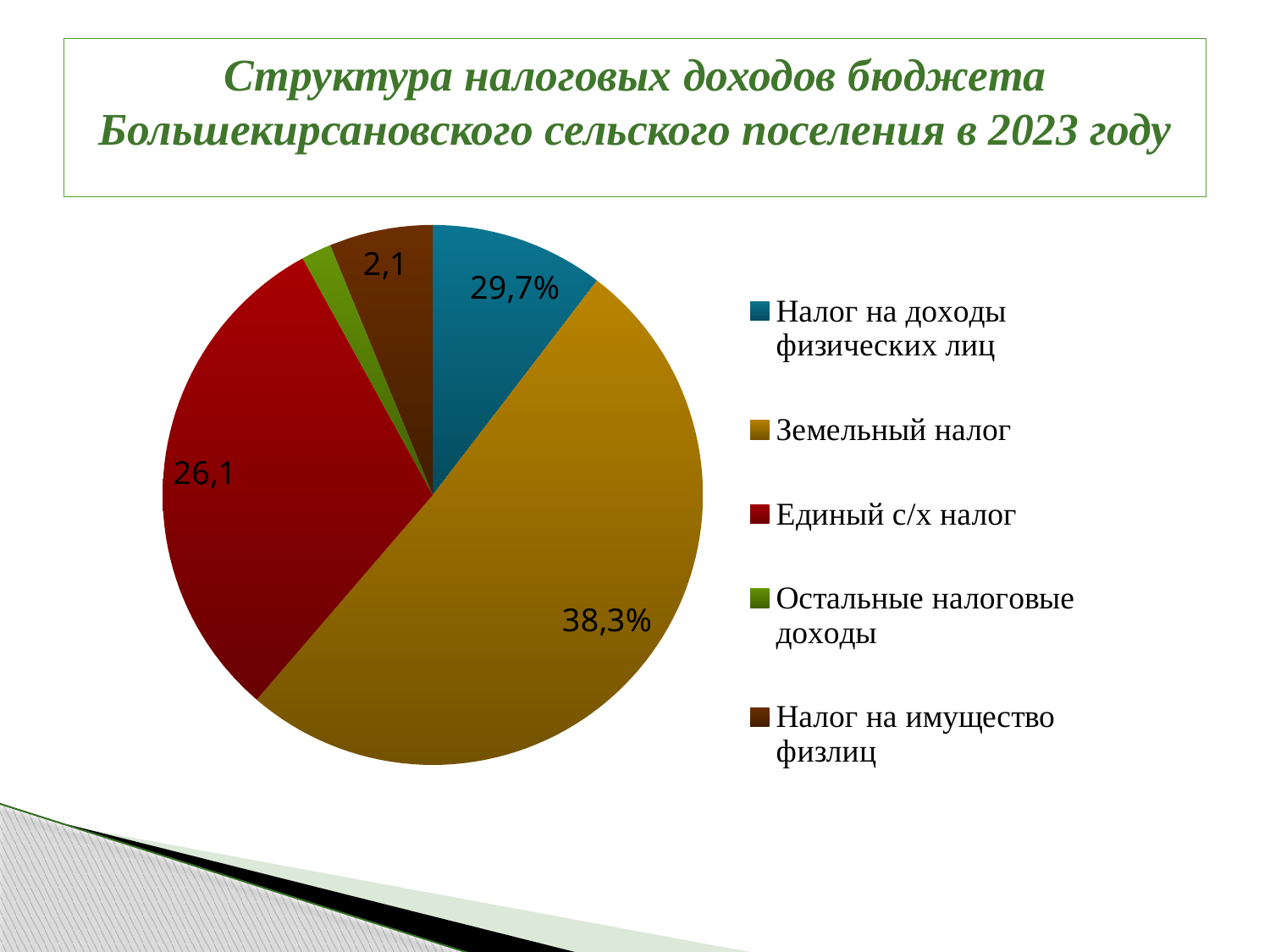
How many entries does the legend list? 5 What is the value shown for Налог на доходы физических лиц? 29,7% Which category has the smallest slice of the pie? Остальные налоговые доходы What is the value shown for Земельный налог? 38,3% What is the value shown for Налог на имущество физлиц? 2,1 How many slices does the pie chart have? 5 What is the value shown for Единый с/х налог? 26,1 What is the difference between the values for Земельный налог and Налог на доходы физических лиц? 8,6 Which category has the largest slice of the pie? Земельный налог What colour is the slice for Единый с/х налог? red What kind of chart is shown on the slide? pie chart